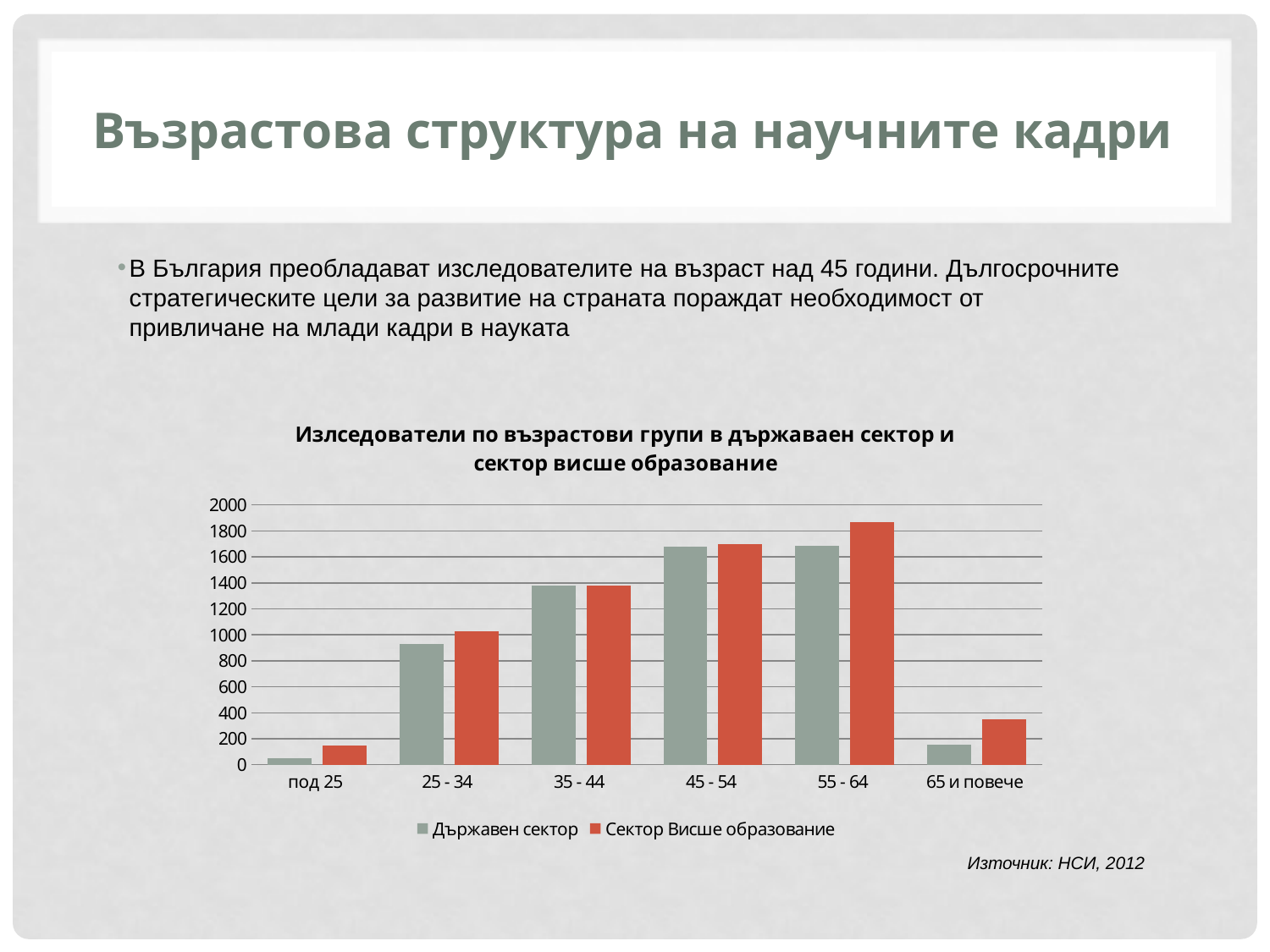
Is the value for Сектор Висше образование in the 65 и повече group greater or less than 400? less Is the value for Сектор Висше образование in the 55 - 64 group greater or less than 1800? greater Do the values for Сектор Висше образование rise or fall from под 25 to 55 - 64? rise Which age group has the lowest value for Сектор Висше образование? под 25 Which age group has the highest value for Сектор Висше образование? 55 - 64 Is the value for Държавен сектор in the 25 - 34 group greater or less than 1000? less What are the two series named in the chart legend? Държавен сектор and Сектор Висше образование What kind of chart is shown on the slide? bar chart In the 65 и повече group, which series has the larger value, Държавен сектор or Сектор Висше образование? Сектор Висше образование How many age groups are shown on the x axis of the chart? 6 Which age group has the lowest value for Държавен сектор? под 25 How many series does the chart legend list? 2